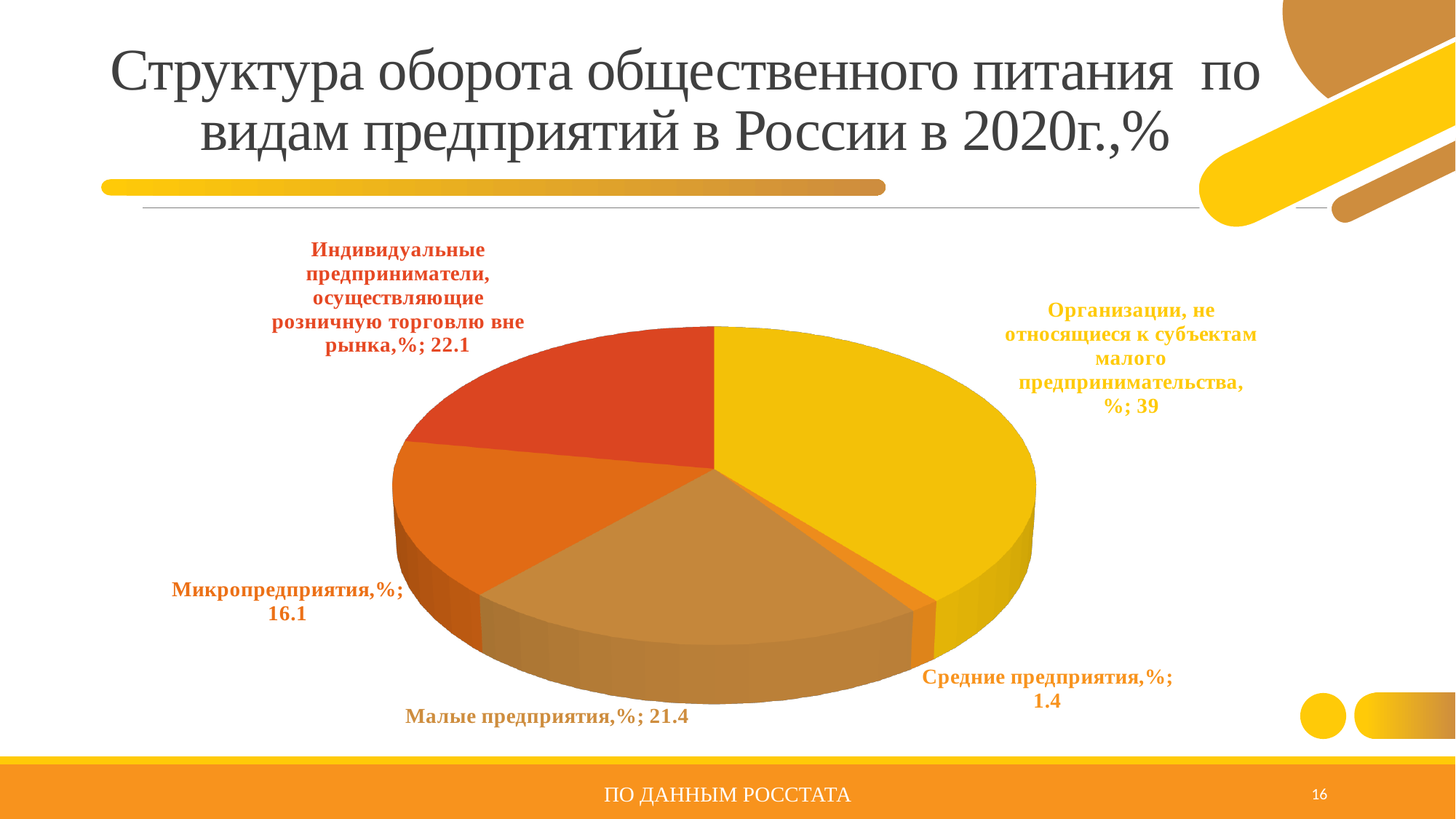
What is the value for Микропредприятия? 16.1 What is the title of the chart on the slide? Структура оборота общественного питания по видам предприятий в России в 2020г.,% What is the difference between the values for Организации, не относящиеся к субъектам малого предпринимательства and Малые предприятия? 17.6 Which is larger, the value for Малые предприятия or the value for Микропредприятия? Малые предприятия What is the value for Малые предприятия? 21.4 What is the value for Индивидуальные предприниматели, осуществляющие розничную торговлю вне рынка? 22.1 Which category has the smallest share of the pie? Средние предприятия What is the value for Средние предприятия? 1.4 What is the value for Организации, не относящиеся к субъектам малого предпринимательства? 39 Which category has the largest share of the pie? Организации, не относящиеся к субъектам малого предпринимательства How many slices does the pie chart have? 5 What kind of chart is shown on the slide? Pie chart